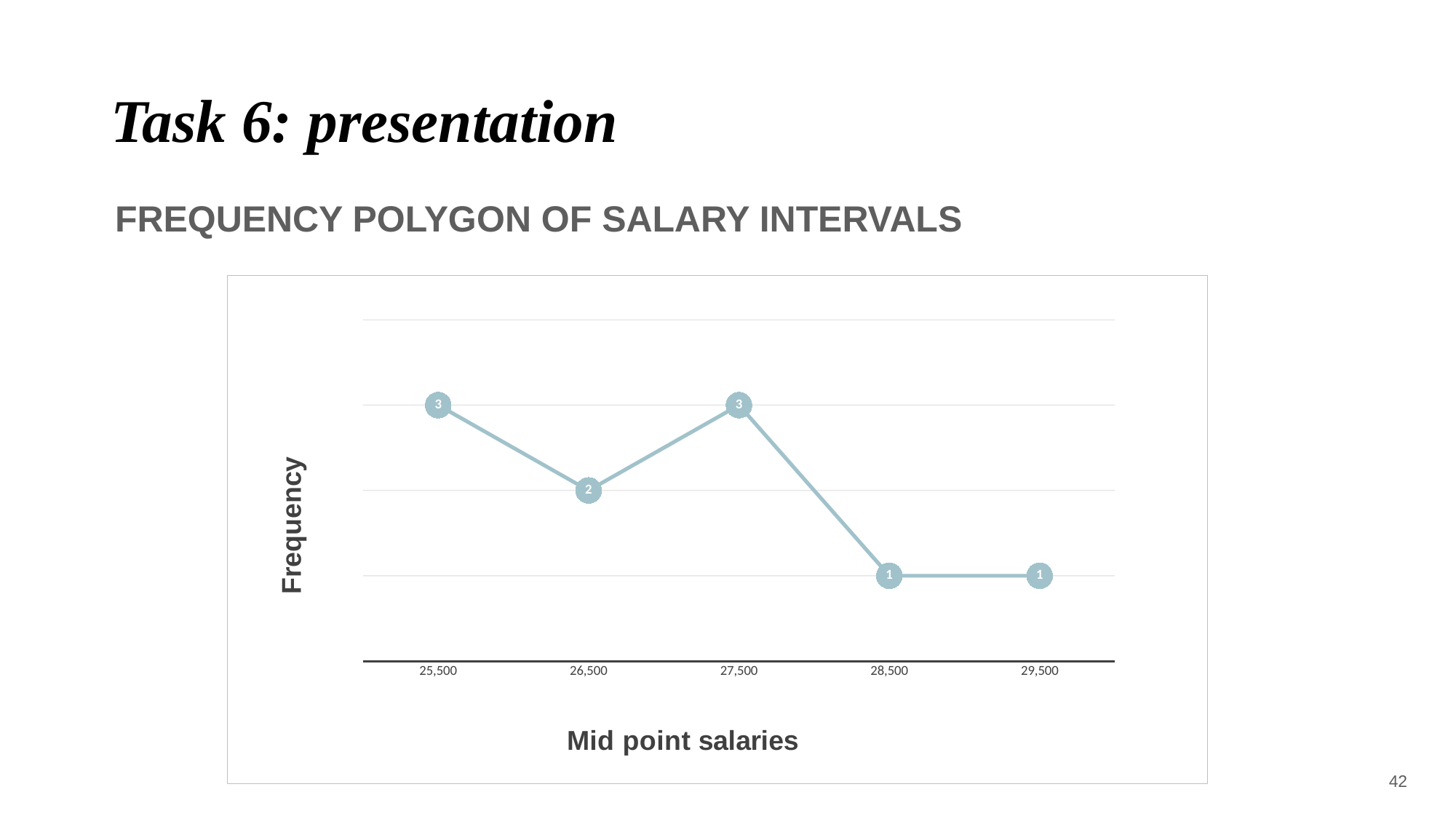
Which has a higher frequency, 25,500 or 29,500? 25,500 What kind of chart is shown on the slide? Line chart What is the label of the x axis? Mid point salaries What is the frequency for the mid point salary of 25,500? 3 What is the frequency for the mid point salary of 28,500? 1 How many mid point salaries are plotted on the chart? 5 Which has a higher frequency, 26,500 or 27,500? 27,500 Which mid point salary has the lowest frequency? 28,500 and 29,500 What is the frequency for the mid point salary of 26,500? 2 Does the frequency generally rise or fall as the mid point salary increases? Fall What is the difference in frequency between 27,500 and 26,500? 1 What is the difference in frequency between 25,500 and 28,500? 2